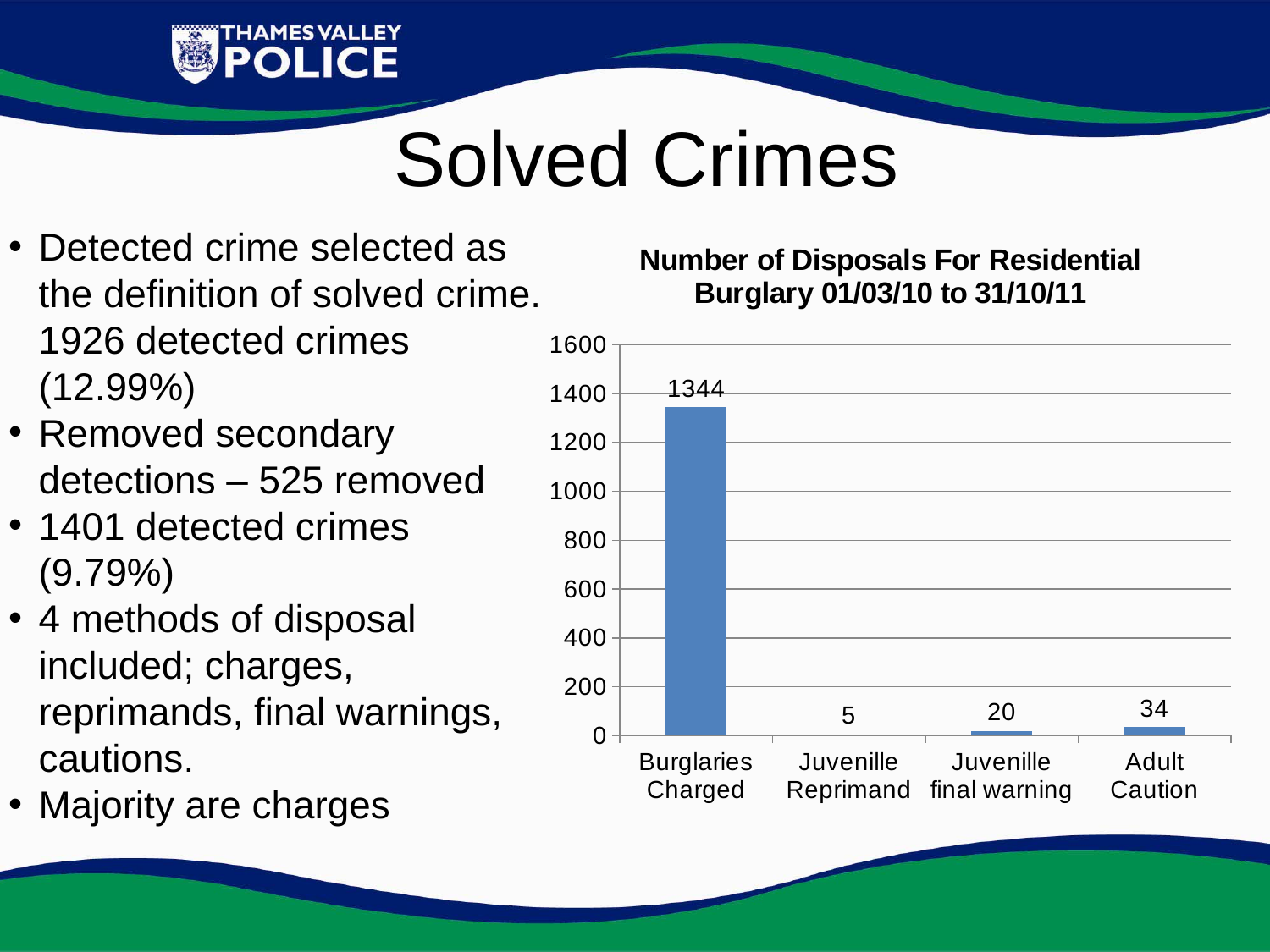
Which category has the lowest value? Juvenille Reprimand What is the value for Juvenille Reprimand? 5 What is the value for Adult Caution? 34 What kind of chart is shown on the slide? bar chart Is the value for Burglaries Charged greater or less than 1200? greater Which category has the highest value? Burglaries Charged How many categories are shown on the x axis? 4 What is the value for Juvenille final warning? 20 What is the value for Burglaries Charged? 1344 What is the difference between the values for Burglaries Charged and Adult Caution? 1310 What is the difference between the values for Adult Caution and Juvenille final warning? 14 Which is larger, the value for Adult Caution or the value for Juvenille final warning? Adult Caution